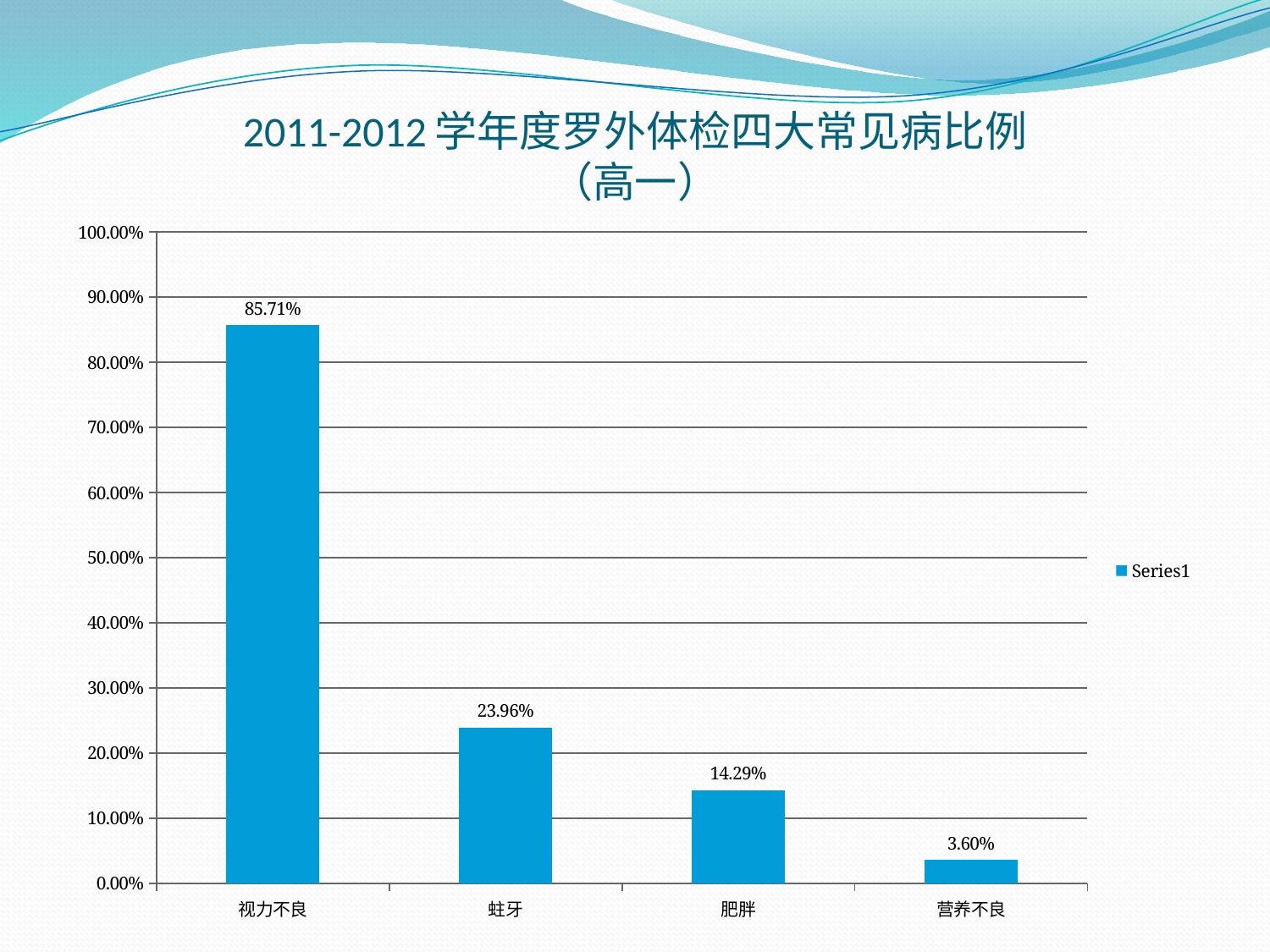
What is the value for 营养不良? 3.60% What is the value for 肥胖? 14.29% Which category has the highest value? 视力不良 How many categories are shown on the x axis? 4 Is the value for 视力不良 greater or less than 80.00%? greater What is the value for 视力不良? 85.71% Which category has the lowest value? 营养不良 What is the value for 蛀牙? 23.96% What is the difference between the values for 蛀牙 and 肥胖? 9.67% How many series does the legend list? 1 What kind of chart is shown on the slide? bar chart Which is larger, the value for 肥胖 or the value for 营养不良? 肥胖